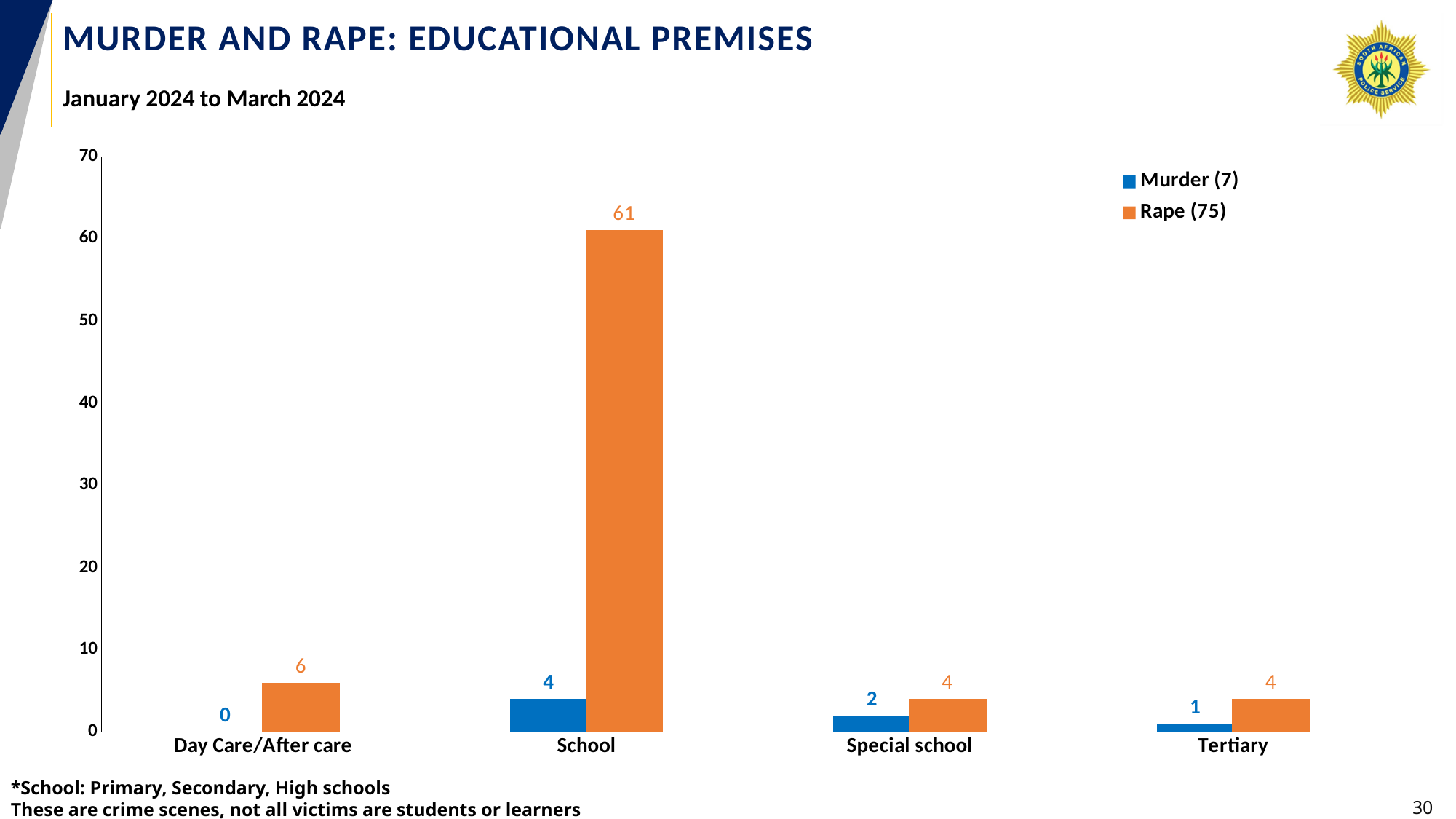
How many series does the legend list? 2 Which category has the highest Rape value? School Which is larger, the Murder value for School or the Murder value for Tertiary? School What is the Murder value for Day Care/After care? 0 What is the Rape value for School? 61 How many categories are shown on the x axis? 4 What is the Rape value for Tertiary? 4 Which category has the lowest Murder value? Day Care/After care What total is shown in the legend entry for Rape? 75 What is the difference between the Rape value for School and the Rape value for Day Care/After care? 55 What is the Murder value for Special school? 2 What kind of chart is shown on the slide? Bar chart